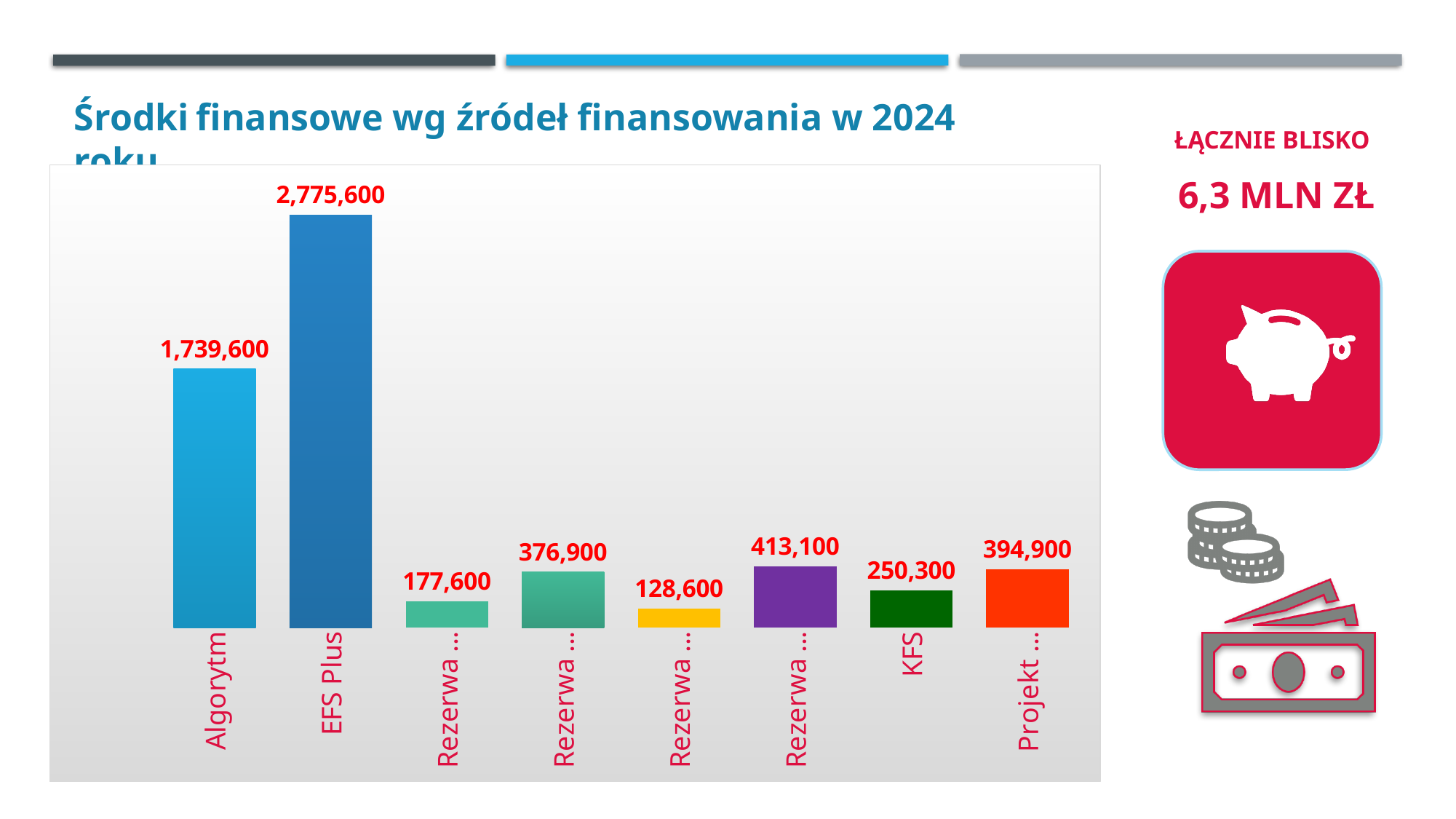
What kind of chart is shown on the slide? Bar chart Which funding source has the highest value? EFS Plus What is the value for EFS Plus? 2,775,600 Which is larger, the value for Algorytm or the value for KFS? Algorytm What total amount is stated next to the chart? 6,3 MLN ZŁ What is the lowest value shown on the chart? 128,600 How many bars are shown on the chart? 8 What is the difference between the values for EFS Plus and Algorytm? 1,036,000 What is the title of the chart? Środki finansowe wg źródeł finansowania w 2024 roku What is the value for Algorytm? 1,739,600 What is the difference between the values for Algorytm and KFS? 1,489,300 What is the value for KFS? 250,300